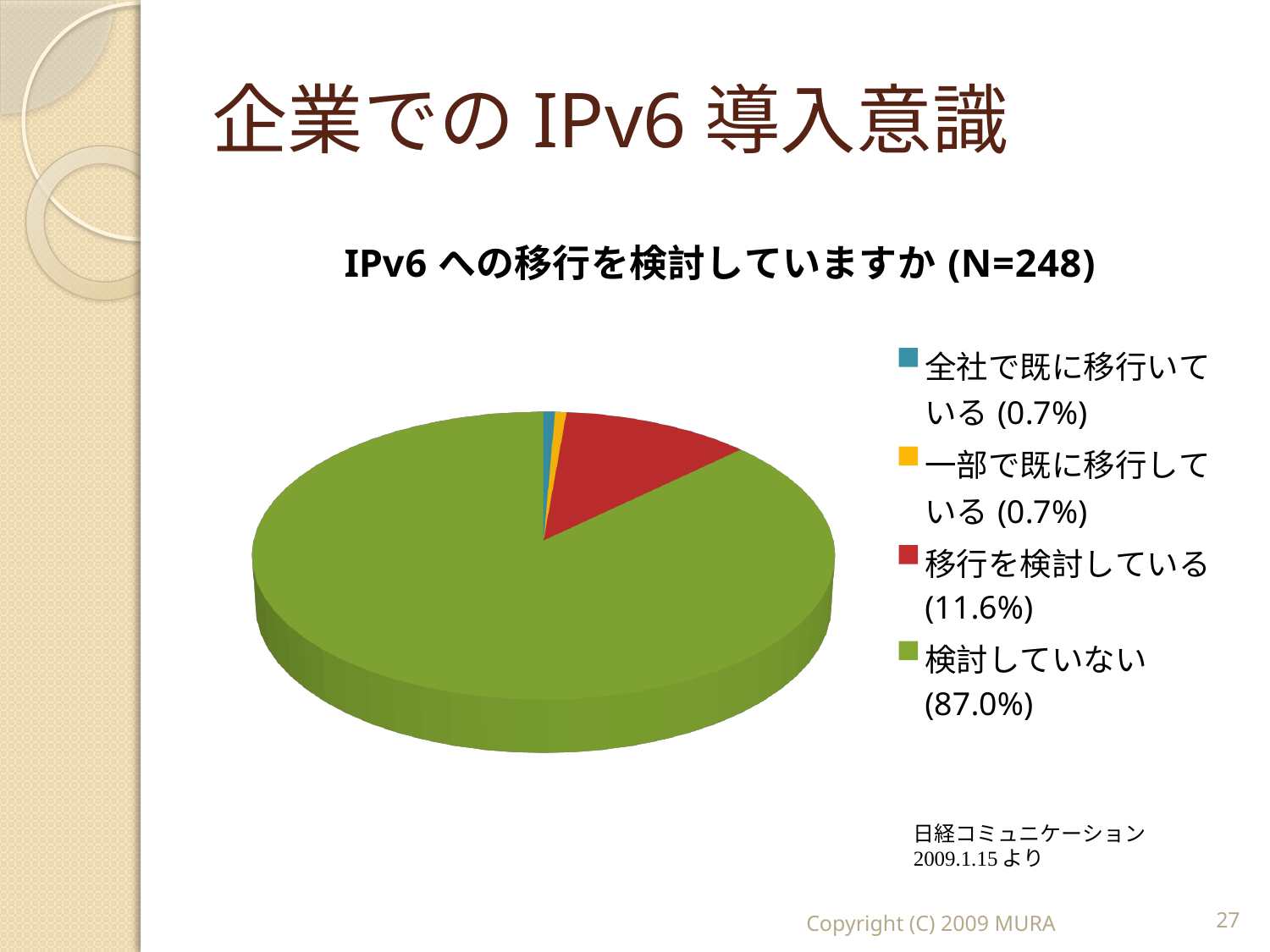
What kind of chart is shown on the slide? pie chart What is the sample size (N) stated in the chart title? 248 What percentage of respondents answered 一部で既に移行している? 0.7% What percentage of respondents answered 検討していない? 87.0% What is the title of the pie chart? IPv6 への移行を検討していますか (N=248) What is the difference in percentage points between 検討していない and 移行を検討している? 75.4 What percentage of respondents answered 移行を検討している? 11.6% Which is larger, the share for 移行を検討している or the share for 一部で既に移行している? 移行を検討している What share of the pie does the 移行を検討している slice represent? 11.6% Which category has the largest share of the pie? 検討していない How many categories does the pie chart have? 4 What percentage of respondents answered 全社で既に移行いている? 0.7%